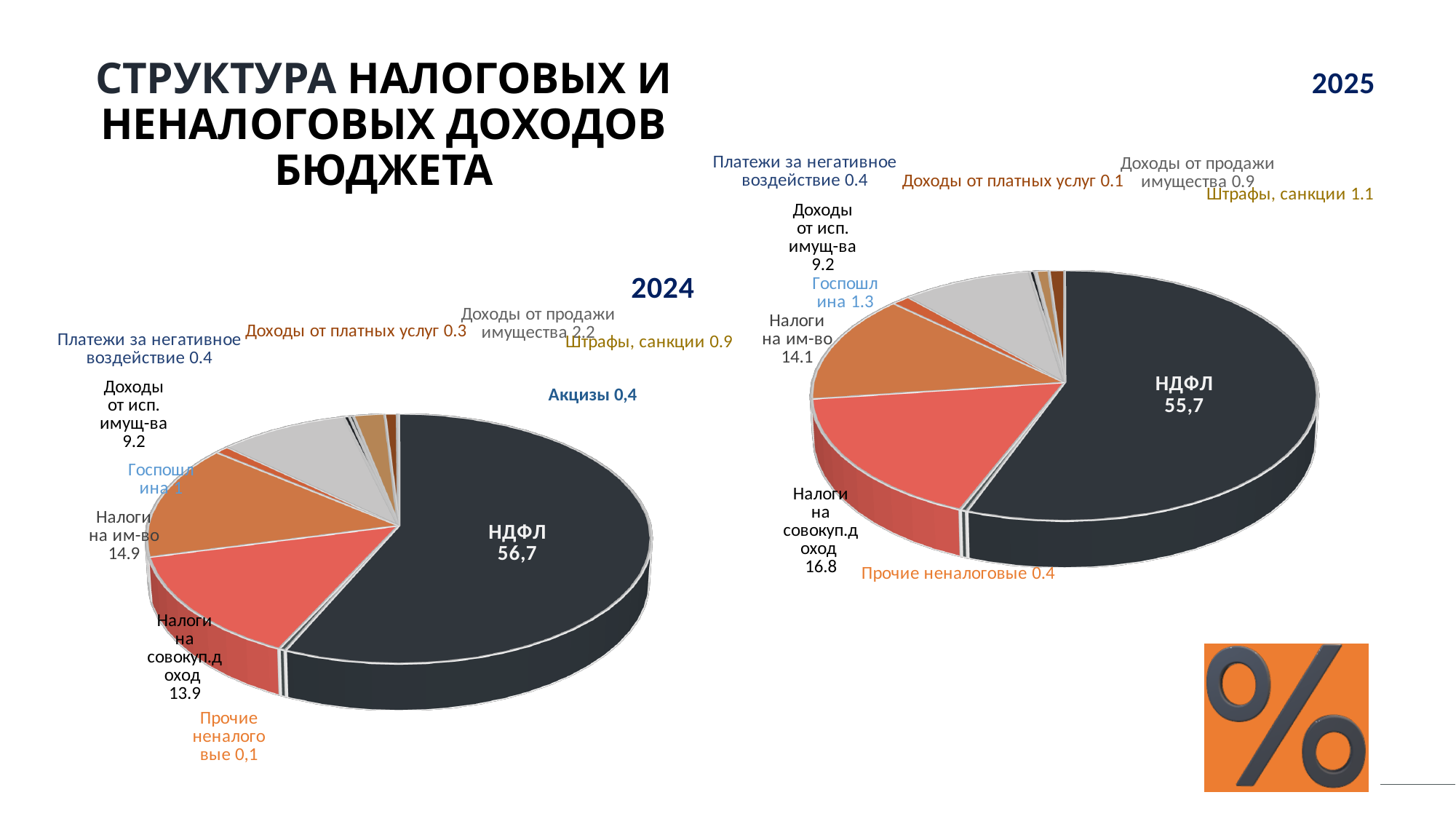
In the 2024 pie chart, which is larger: Налоги на им-во or Налоги на совокуп.доход? Налоги на им-во In the 2025 pie chart, what is the value for Налоги на совокуп.доход? 16.8 In the 2024 pie chart, what is the value for НДФЛ? 56,7 In the 2024 pie chart, what is the value for Налоги на им-во? 14.9 What is the title of the slide? СТРУКТУРА НАЛОГОВЫХ И НЕНАЛОГОВЫХ ДОХОДОВ БЮДЖЕТА In the 2025 pie chart, what is the value for Госпошлина? 1.3 In the 2025 pie chart, what is the value for НДФЛ? 55,7 What type of chart is used for the 2025 data? Pie chart In the 2025 pie chart, which category has the smallest value? Доходы от платных услуг In the 2025 pie chart, what is the difference between Налоги на совокуп.доход and Налоги на им-во? 2.7 In the 2024 pie chart, which category has the smallest value? Прочие неналоговые In the 2024 pie chart, which category has the largest share? НДФЛ